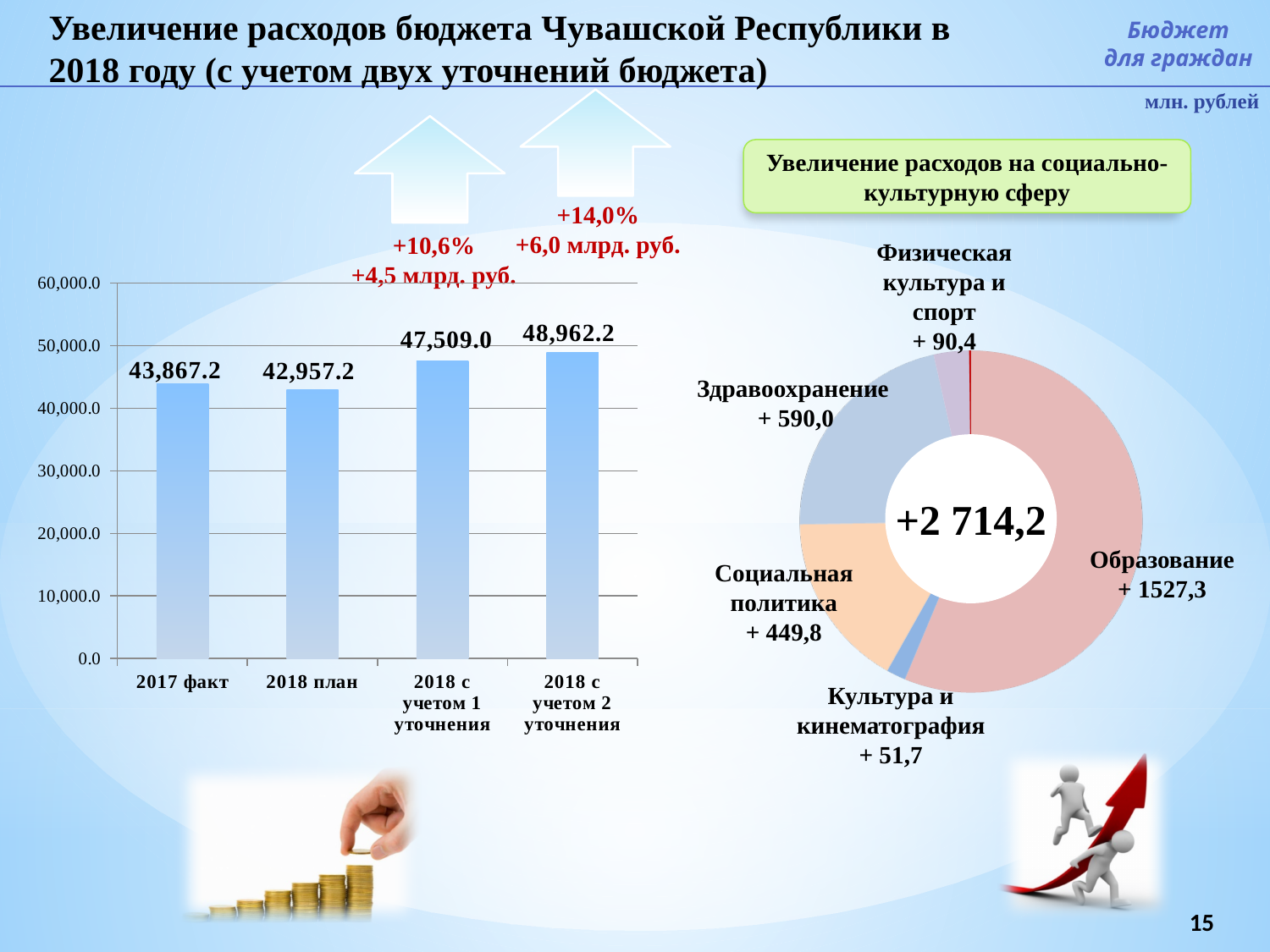
On the bar chart on the left, what is the value for 2018 план? 42,957.2 On the bar chart on the left, which category has the lowest value? 2018 план On the doughnut chart on the right, what is the value shown for Здравоохранение? + 590,0 On the bar chart on the left, how many bars are plotted? 4 On the bar chart on the left, what is the difference between the values for 2018 с учетом 2 уточнения and 2018 с учетом 1 уточнения? 1,453.2 On the bar chart on the left, what is the value for 2018 с учетом 2 уточнения? 48,962.2 On the bar chart on the left, which category has the highest value? 2018 с учетом 2 уточнения On the doughnut chart on the right, which category has the smallest value? Культура и кинематография On the doughnut chart on the right, what is the value shown for Образование? + 1527,3 On the bar chart on the left, which is larger: the value for 2017 факт or the value for 2018 план? 2017 факт On the bar chart on the left, what is the value for 2017 факт? 43,867.2 What kind of chart is shown on the left of the slide? Bar chart